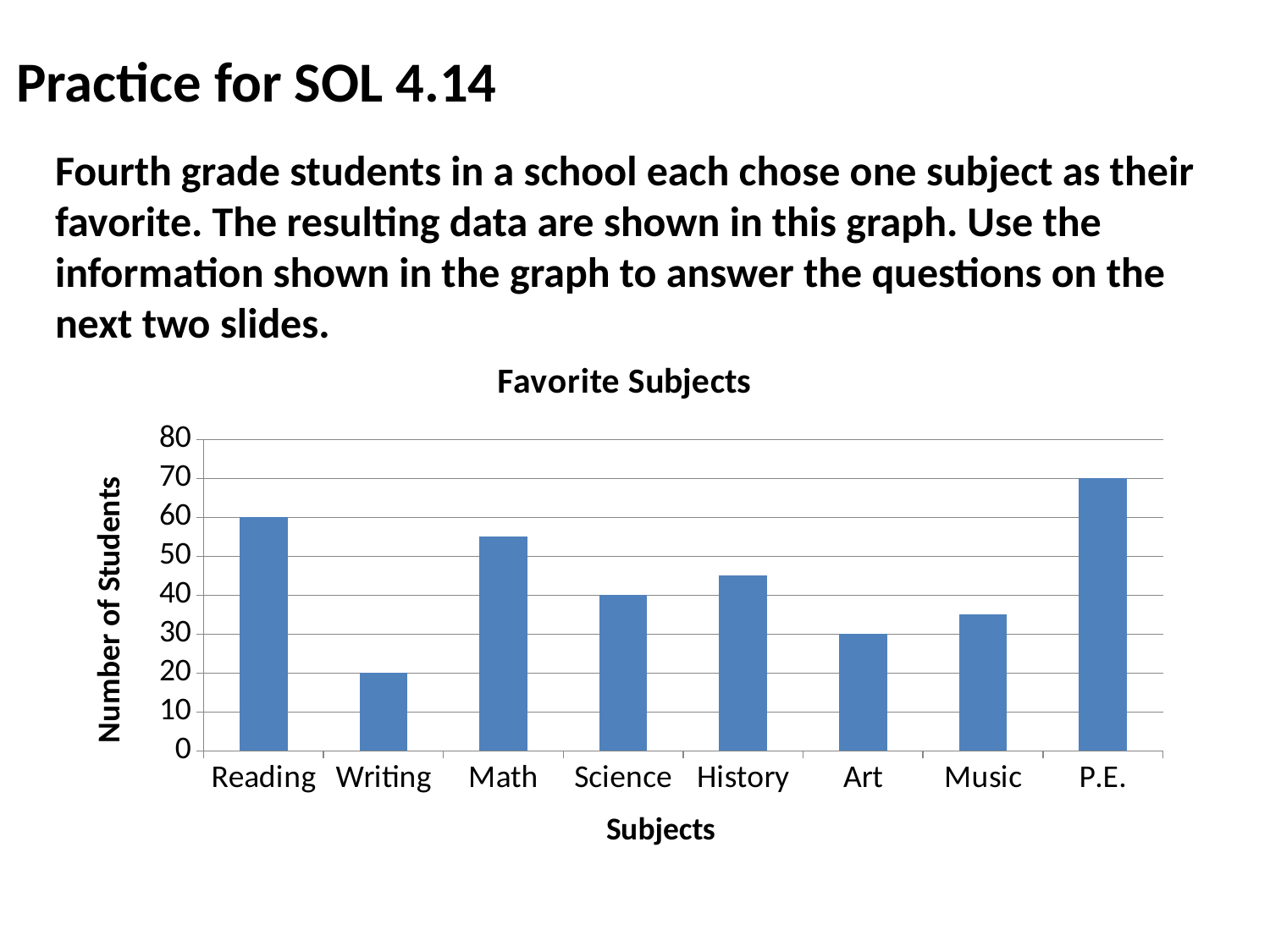
Which subject has the highest number of students? P.E. How many subjects are shown on the x axis? 8 What is the difference between the number of students for P.E. and for Reading? 10 What is the number of students for Writing? 20 Which subject has the lowest number of students? Writing Is the value for Math greater or less than 50? greater What is the number of students for Art? 30 What is the number of students for Reading? 60 What type of chart is shown on the slide? Bar chart Is the value for Music greater or less than 40? less What is the number of students for P.E.? 70 Which has more students, Math or Science? Math